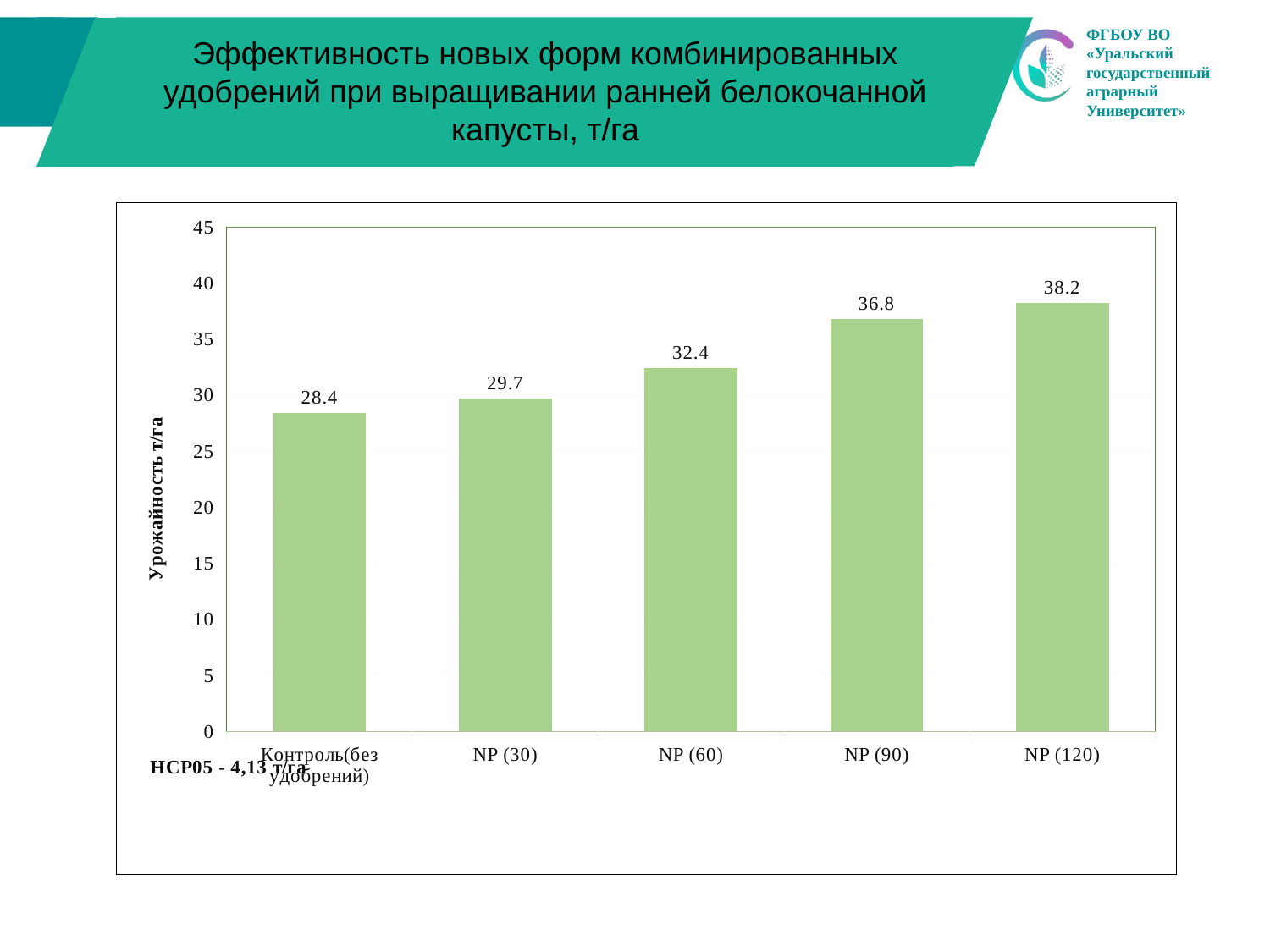
Which category has the highest yield? NP (120) Which category has the lowest yield? Контроль (без удобрений) What is the difference between the yield for NP (120) and the control (Контроль (без удобрений))? 9.8 What is the yield value for NP (120)? 38.2 What is the difference between the yield for NP (90) and NP (60)? 4.4 What is the yield value for the control (Контроль (без удобрений)) bar? 28.4 What is the yield value for NP (60)? 32.4 What kind of chart is shown on the slide? Bar chart How many categories are shown on the x axis? 5 Which is larger, the yield for NP (30) or NP (90)? NP (90) Do the yield values rise or fall from the control to NP (120) along the x axis? Rise Is the value for NP (90) greater or less than 35? greater